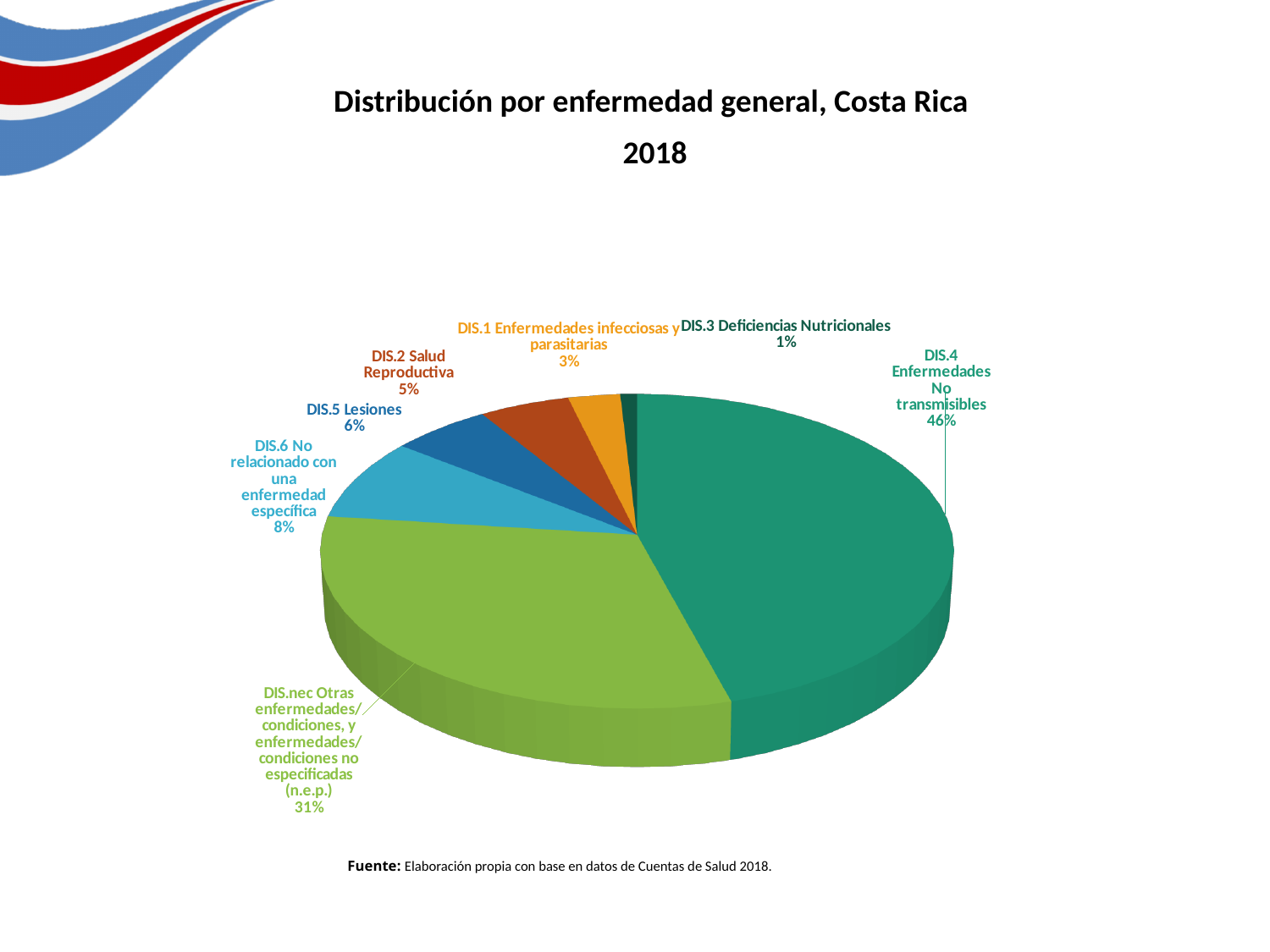
What is the difference in percentage points between DIS.4 Enfermedades No transmisibles and DIS.nec Otras enfermedades/condiciones (n.e.p.)? 15 percentage points Which category has the largest slice of the pie? DIS.4 Enfermedades No transmisibles What percentage is shown for DIS.5 Lesiones? 6% How many categories are shown in the pie chart? 7 What percentage is shown for DIS.6 No relacionado con una enfermedad específica? 8% What share of the pie does DIS.4 Enfermedades No transmisibles represent? 46% What is the value shown for DIS.nec Otras enfermedades/condiciones, y enfermedades/condiciones no especificadas (n.e.p.)? 31% What percentage is shown for DIS.2 Salud Reproductiva? 5% Which is larger, the share for DIS.5 Lesiones or the share for DIS.2 Salud Reproductiva? DIS.5 Lesiones Which category has the smallest slice of the pie? DIS.3 Deficiencias Nutricionales What percentage is shown for DIS.1 Enfermedades infecciosas y parasitarias? 3% What type of chart is shown on the slide? Pie chart